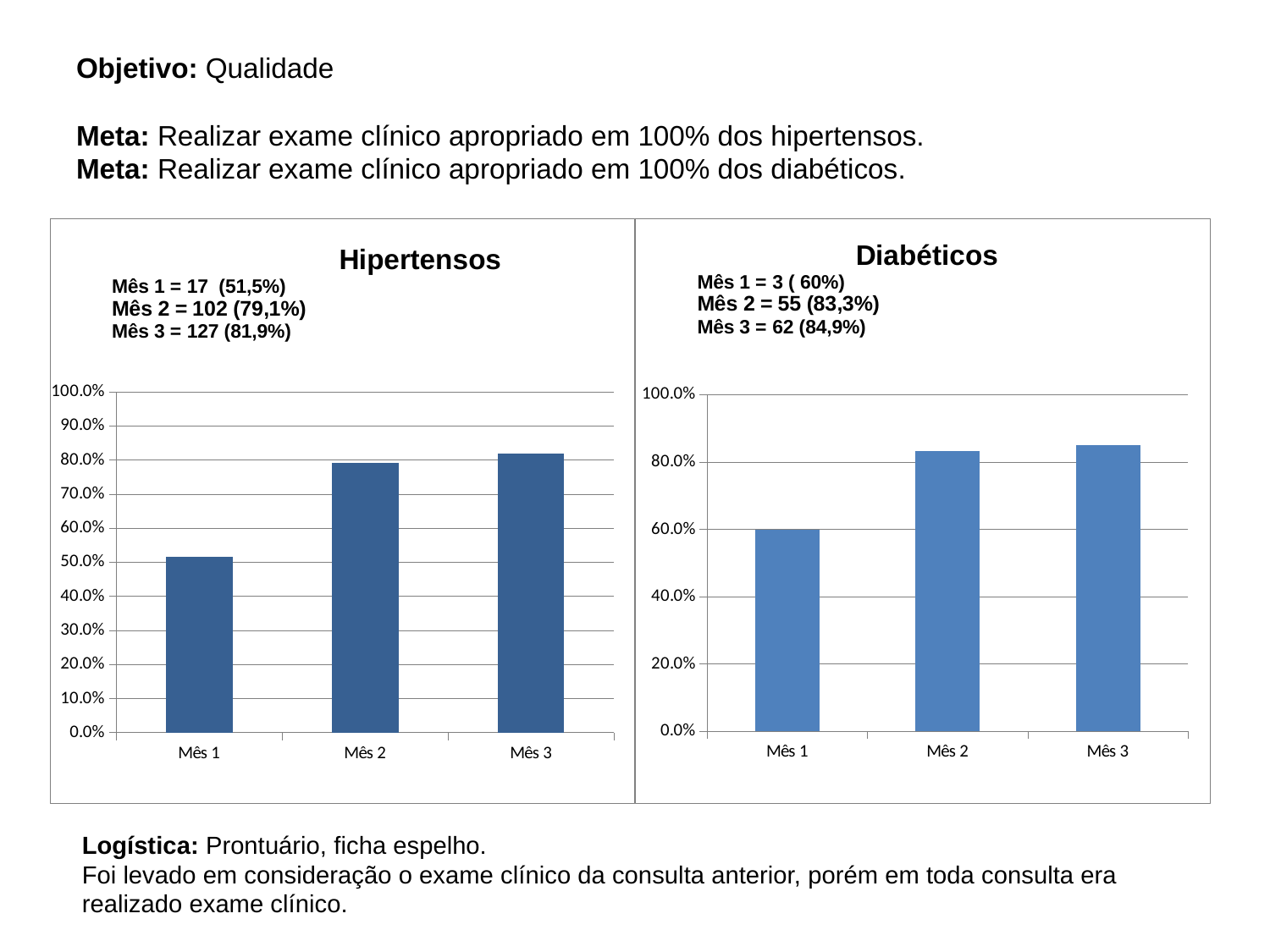
In the Diabéticos chart, how many patients are listed for Mês 3? 62 In the Hipertensos chart, which month has the lowest bar? Mês 1 In the Diabéticos chart, what percentage is shown for Mês 2? 83,3% In the Diabéticos chart, is the bar for Mês 1 greater or less than 80.0%? less In the Diabéticos chart, do the values rise or fall from Mês 1 to Mês 3? Rise In the Hipertensos chart, what percentage is shown for Mês 1? 51,5% In the Hipertensos chart, is the bar for Mês 2 greater or less than 70.0%? greater How many bars does the Diabéticos chart have? 3 In the Hipertensos chart, which is larger, the bar for Mês 1 or the bar for Mês 2? Mês 2 In the Hipertensos chart, what percentage is shown for Mês 3? 81,9% What type of chart is the Hipertensos chart? Bar chart In the Diabéticos chart, which month has the highest bar? Mês 3